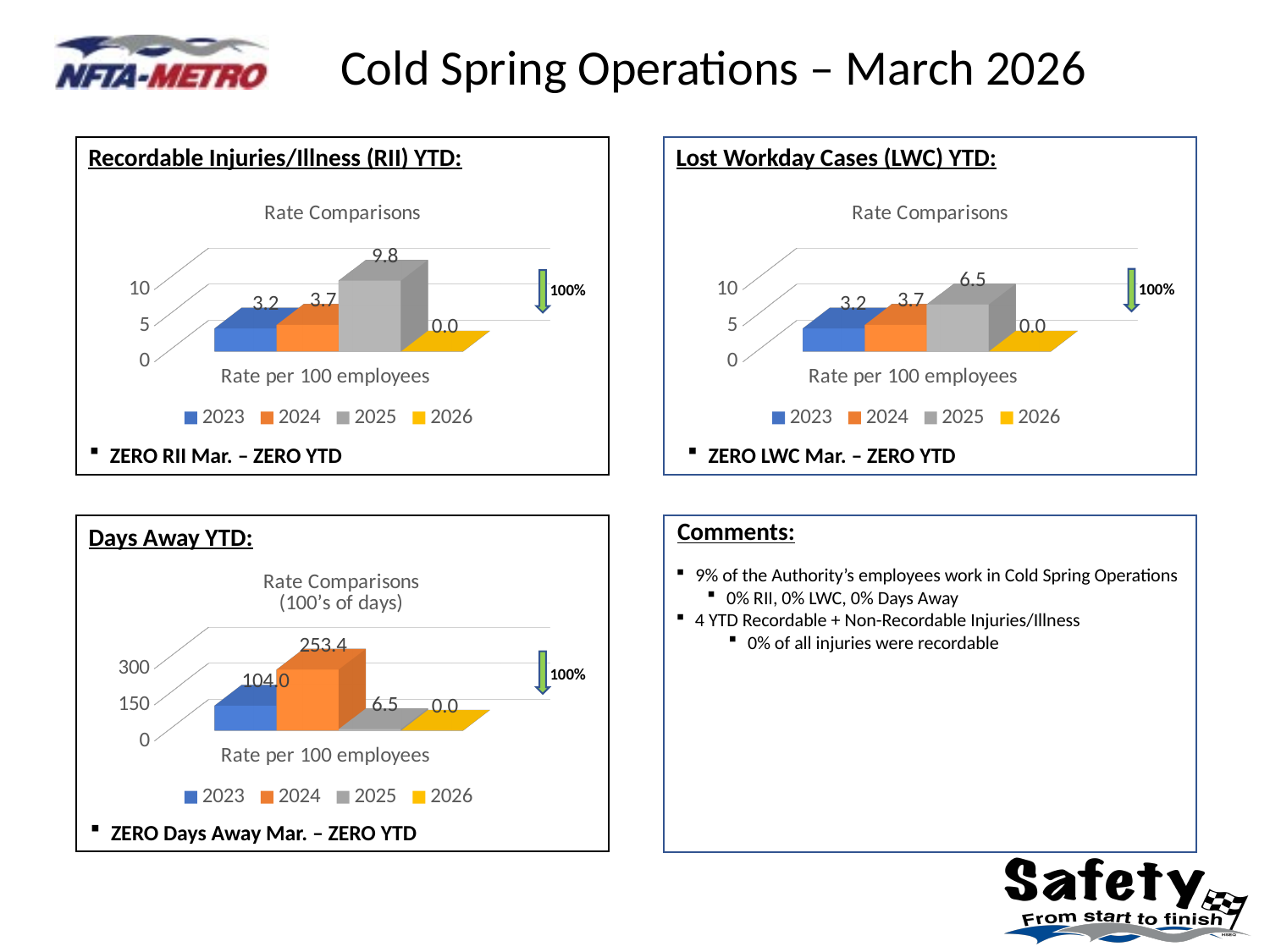
In the Lost Workday Cases (LWC) YTD chart, is the value for 2024 larger or smaller than the value for 2023? larger In the Lost Workday Cases (LWC) YTD chart, what is the value for 2025? 6.5 In the Recordable Injuries/Illness (RII) YTD chart, which year has the highest value? 2025 How many series does the legend list in the Days Away YTD chart? 4 What kind of chart is the Recordable Injuries/Illness (RII) YTD chart? bar chart What is the x-axis label of the Lost Workday Cases (LWC) YTD chart? Rate per 100 employees In the Days Away YTD chart, what is the value for 2023? 104.0 In the Days Away YTD chart, what is the difference between the 2024 and 2023 values? 149.4 In the Lost Workday Cases (LWC) YTD chart, which year has the lowest value? 2026 In the Days Away YTD chart, what is the value for 2024? 253.4 In the Recordable Injuries/Illness (RII) YTD chart, what is the difference between the 2025 and 2024 values? 6.1 In the Recordable Injuries/Illness (RII) YTD chart, what is the value for 2025? 9.8